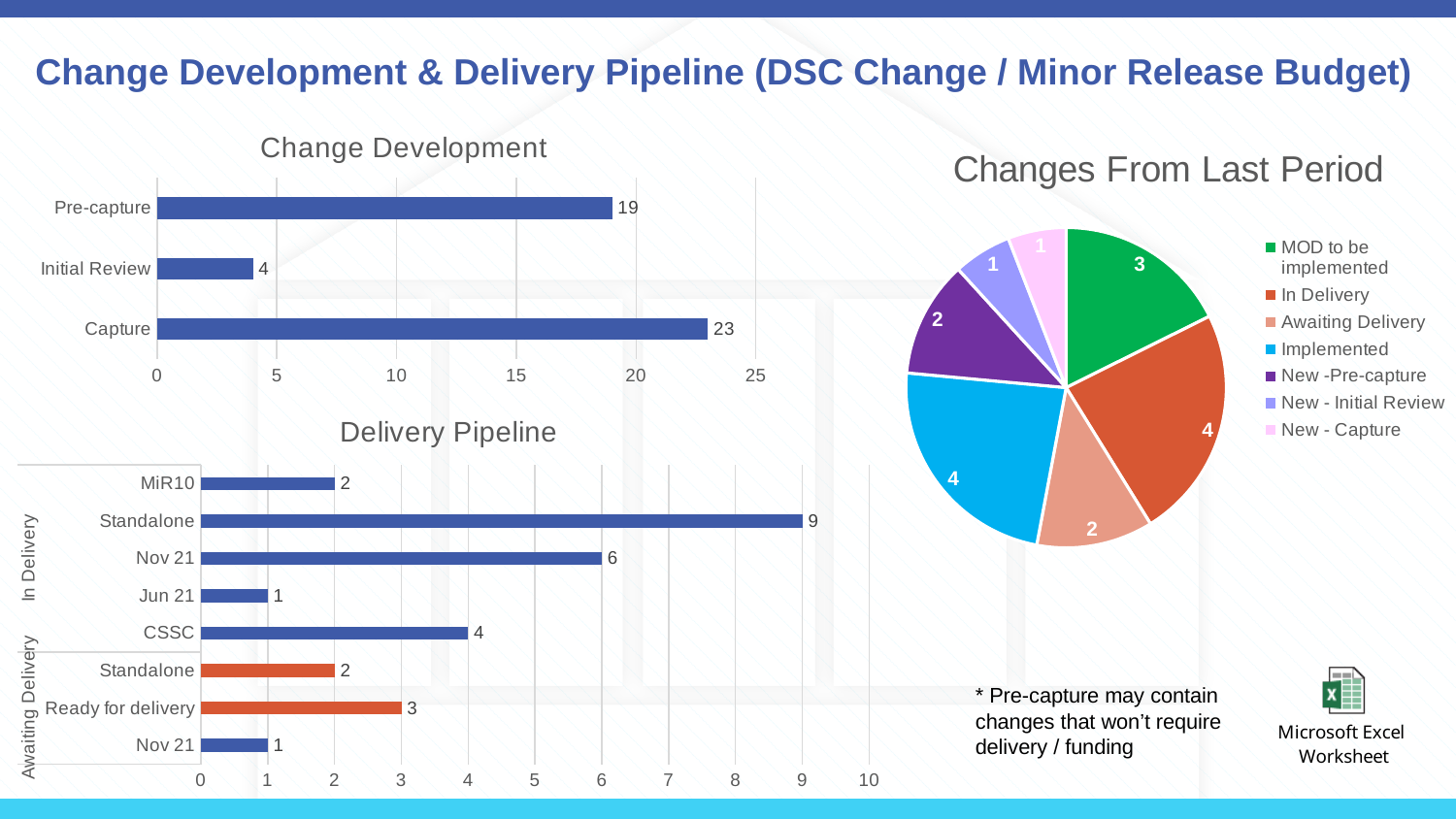
In the Delivery Pipeline chart, which category has the highest value? Standalone (In Delivery) In the Change Development chart, which category has the lowest value? Initial Review In the Change Development chart, what is the difference between Capture and Pre-capture? 4 In the Delivery Pipeline chart, which is larger: Nov 21 in the In Delivery group or CSSC? Nov 21 (In Delivery) What kind of chart is Changes From Last Period? Pie chart In the Change Development chart, how many categories are shown? 3 In the Delivery Pipeline chart, how many bars are plotted? 8 In the Changes From Last Period chart, what is the value for Implemented? 4 In the Delivery Pipeline chart, what is the value for Standalone in the In Delivery group? 9 In the Change Development chart, what is the value for Capture? 23 In the Delivery Pipeline chart, what is the value for Ready for delivery? 3 How many entries does the legend of the Changes From Last Period chart list? 7